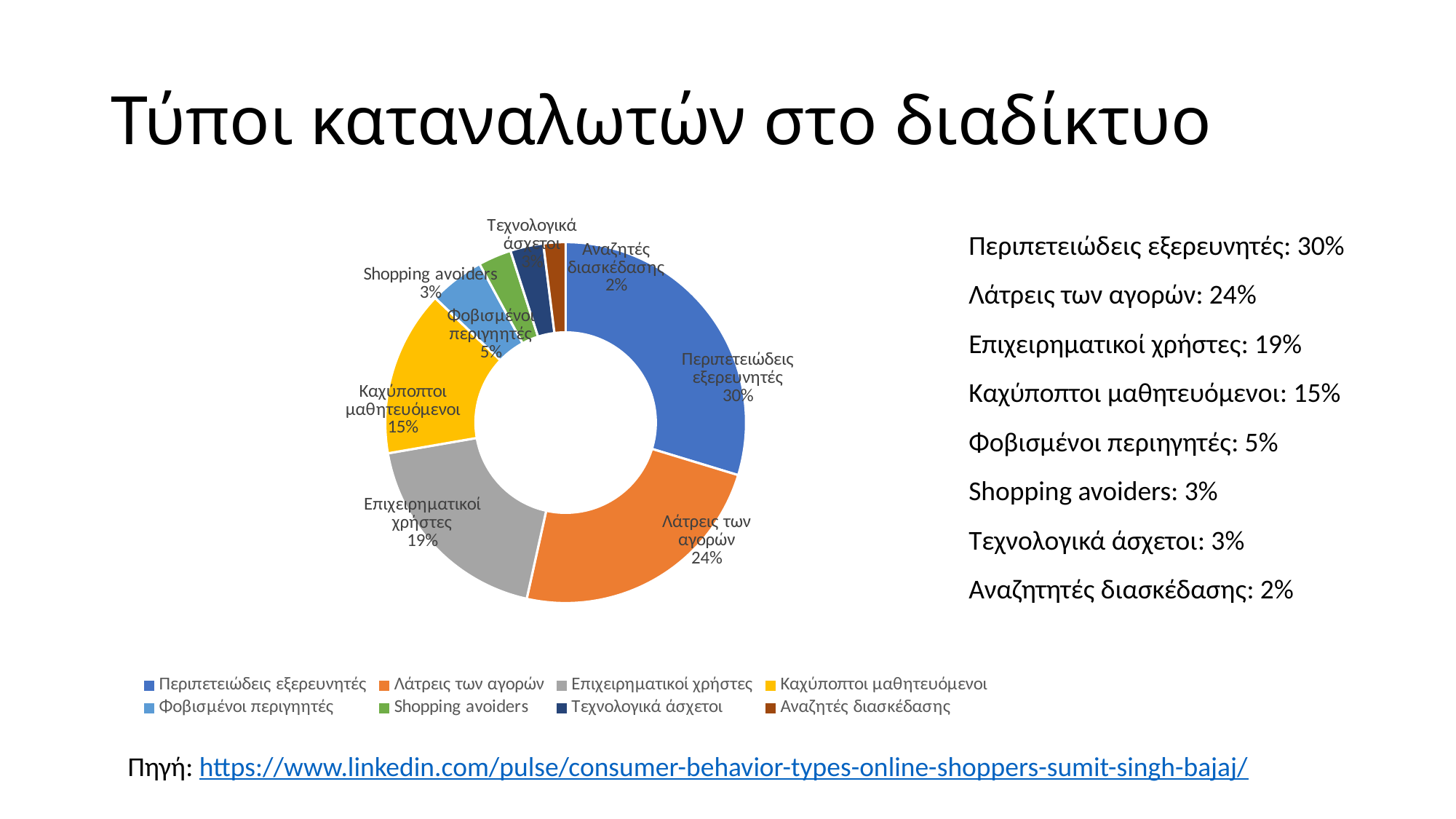
What colour is the slice for Λάτρεις των αγορών? Orange What is the value shown for Φοβισμένοι περιηγητές? 5% How many categories are shown in the chart? 8 What share of the pie does Περιπετειώδεις εξερευνητές represent? 30% What is the value shown for Λάτρεις των αγορών? 24% What is the value shown for Επιχειρηματικοί χρήστες? 19% What kind of chart is shown on the slide? Pie (doughnut) chart Which category has the smallest slice of the chart? Αναζητητές διασκέδασης Which category has the largest slice of the chart? Περιπετειώδεις εξερευνητές How many entries does the legend list? 8 What is the difference between the values for Περιπετειώδεις εξερευνητές and Λάτρεις των αγορών? 6% Which is larger, the value for Καχύποπτοι μαθητευόμενοι or the value for Επιχειρηματικοί χρήστες? Επιχειρηματικοί χρήστες